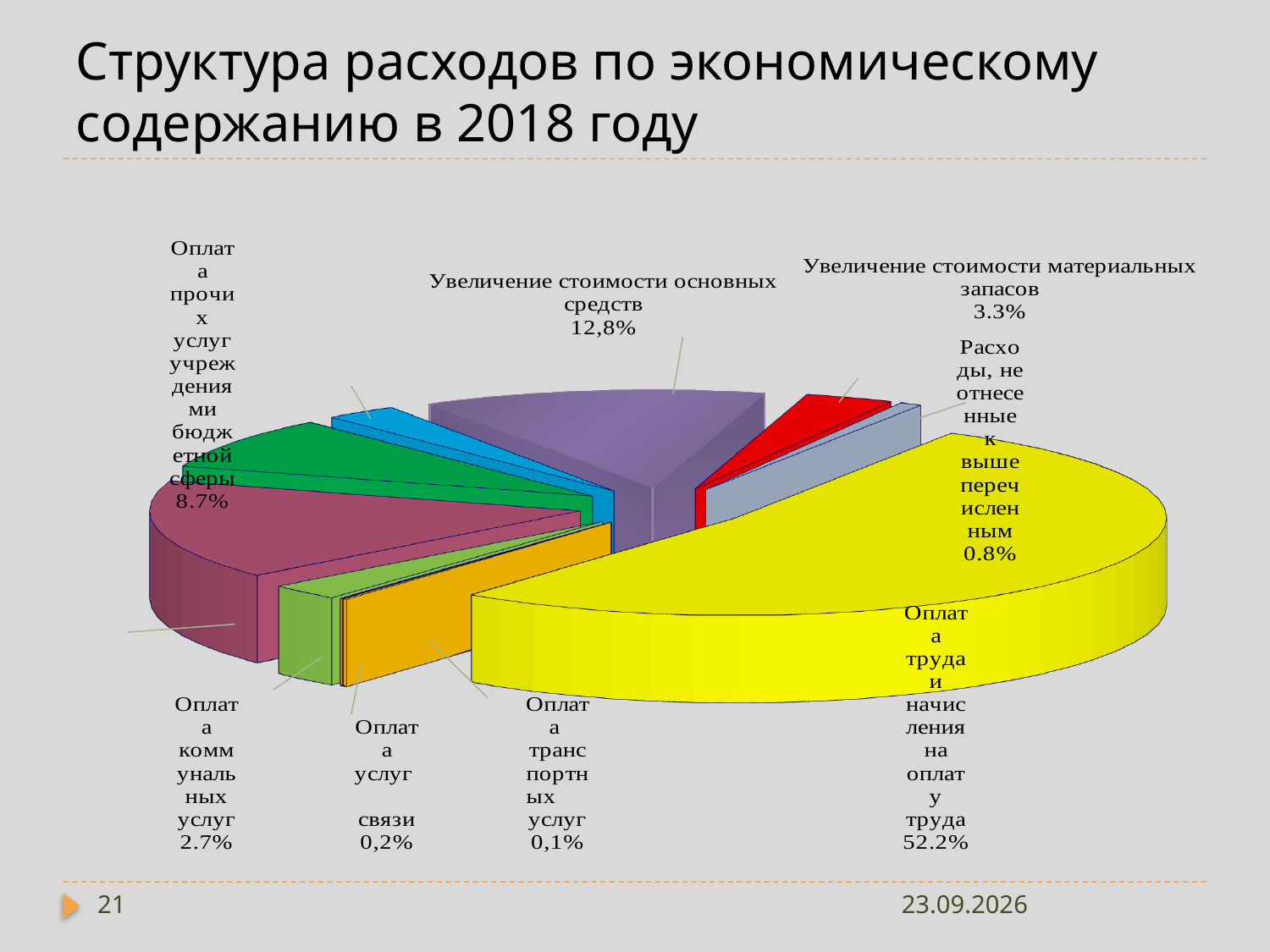
Which labelled category has the smallest share of expenses? Оплата транспортных услуг What share is shown for "Оплата прочих услуг учреждениями бюджетной сферы"? 8.7% What share of expenses is shown for "Оплата труда и начисления на оплату труда"? 52.2% What share is shown for "Оплата услуг связи"? 0,2% Which labelled category has the largest share of expenses? Оплата труда и начисления на оплату труда What percentage is labelled for "Расходы, не отнесенные к вышеперечисленным"? 0.8% What percentage is labelled for "Увеличение стоимости основных средств"? 12,8% Which is larger: the share for "Увеличение стоимости основных средств" or for "Увеличение стоимости материальных запасов"? Увеличение стоимости основных средств By how many percentage points does "Оплата труда и начисления на оплату труда" exceed "Увеличение стоимости основных средств"? 39.4 What type of chart is shown on the slide? Pie chart What percentage is labelled for "Оплата коммунальных услуг"? 2.7% What share is shown for "Увеличение стоимости материальных запасов"? 3.3%